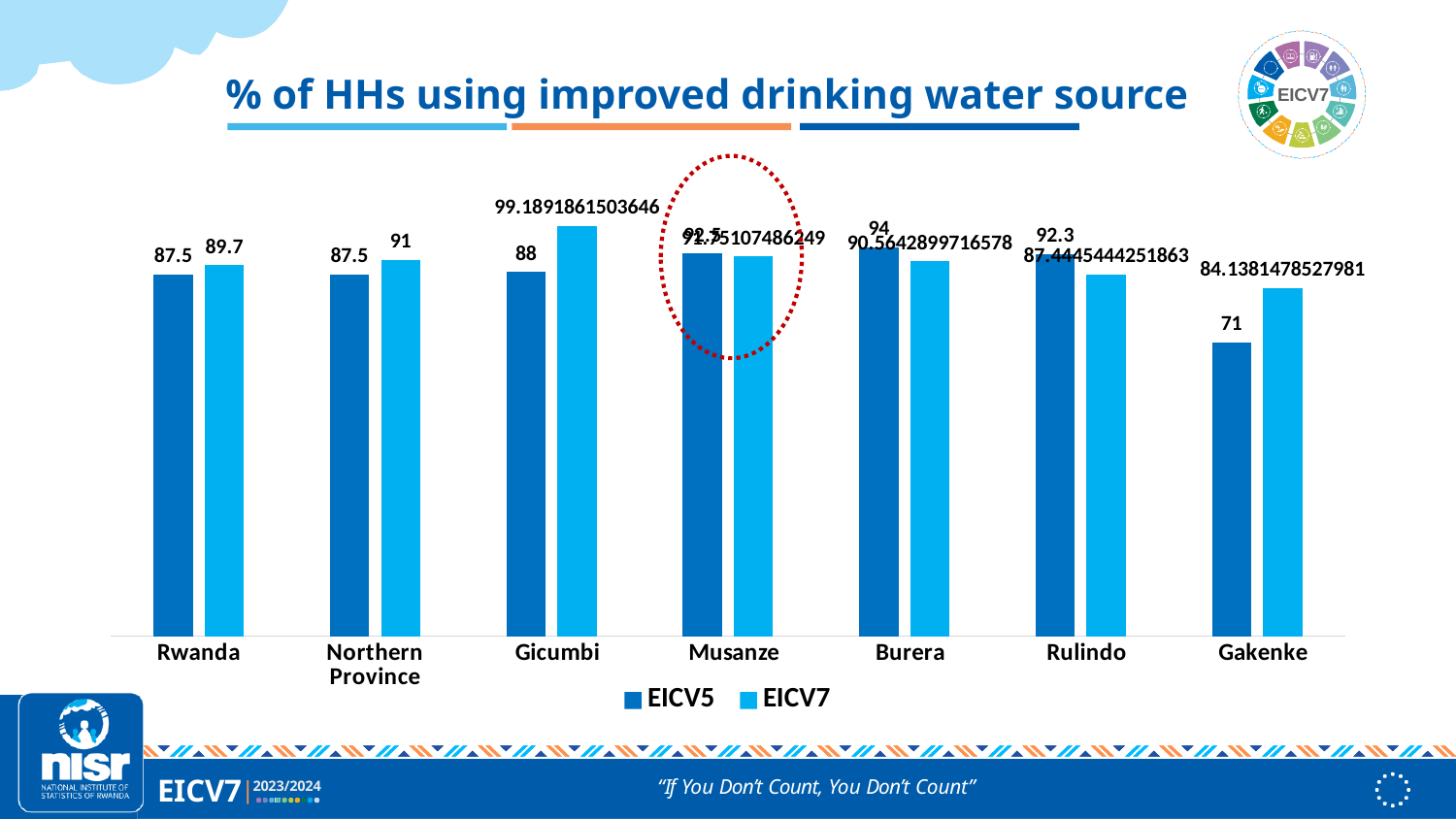
What is the EICV7 value for Gicumbi? 99.1891861503646 By how much did the value for Rwanda increase from EICV5 to EICV7? 2.2 For Rulindo, which is larger: the EICV5 value or the EICV7 value? EICV5 What kind of chart is shown on the slide? bar chart What is the EICV7 value for Rwanda? 89.7 What is the difference between the EICV7 and EICV5 values for Northern Province? 3.5 Which category has the lowest EICV5 value? Gakenke How many categories are shown on the x axis? 7 Which category has the highest EICV7 value? Gicumbi What is the EICV5 value for Gakenke? 71 How many series does the legend list? 2 What is the EICV5 value for Burera? 94